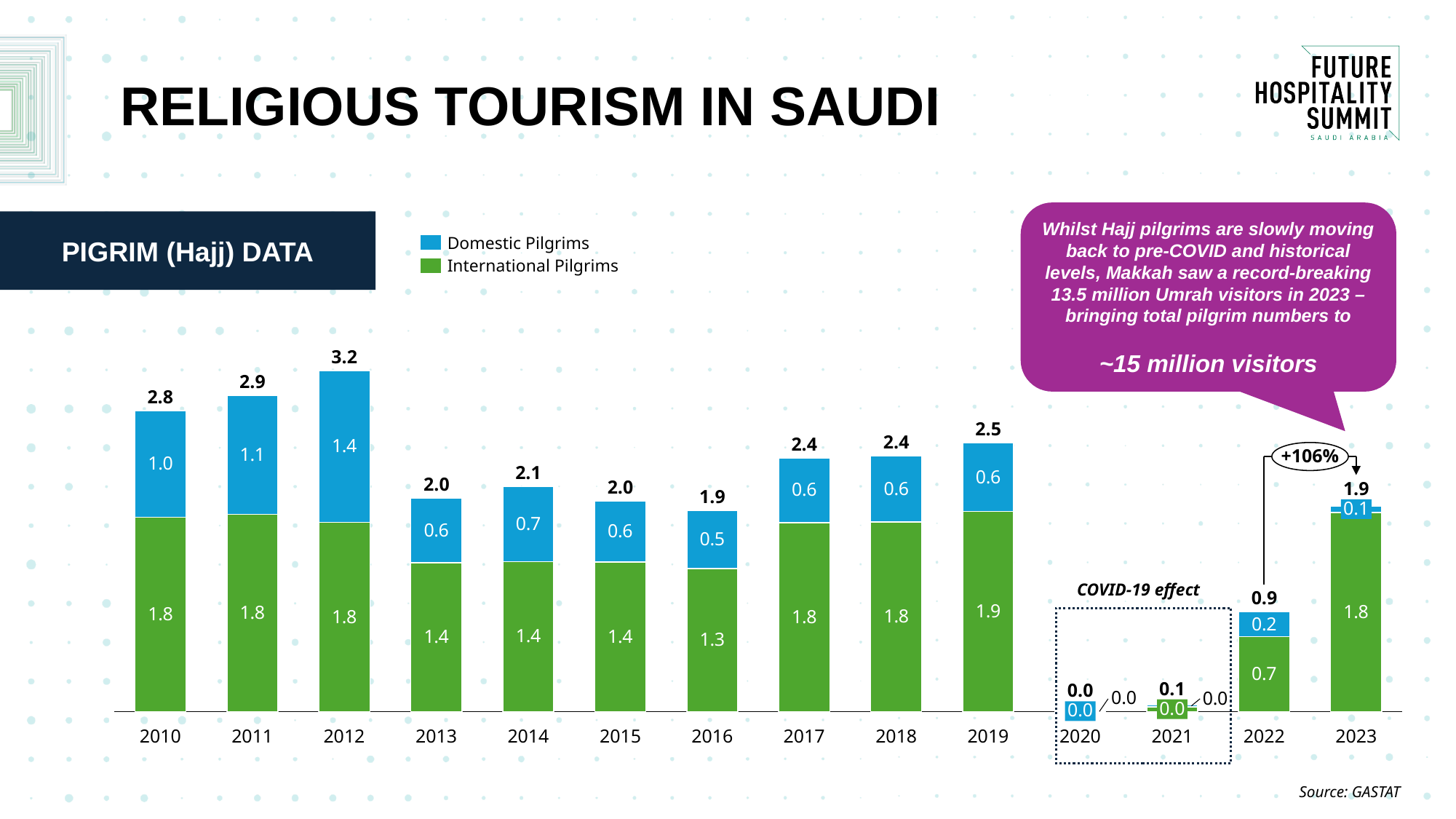
What is the total of the stacked bar for 2022? 0.9 What is the total number of Hajj pilgrims shown for 2012? 3.2 What is the difference between the total for 2012 and the total for 2013? 1.2 What is the value for Domestic Pilgrims in 2014? 0.7 What is the value for International Pilgrims in 2019? 1.9 Which colour represents International Pilgrims in the legend? Green Which year has the lowest total number of pilgrims? 2020 How many series does the legend list? 2 How many years are shown on the x axis? 14 What kind of chart is used to show the pilgrim data? Stacked bar chart Which year has the highest total number of pilgrims? 2012 Which is larger, the Domestic Pilgrims value in 2011 or in 2016? 2011